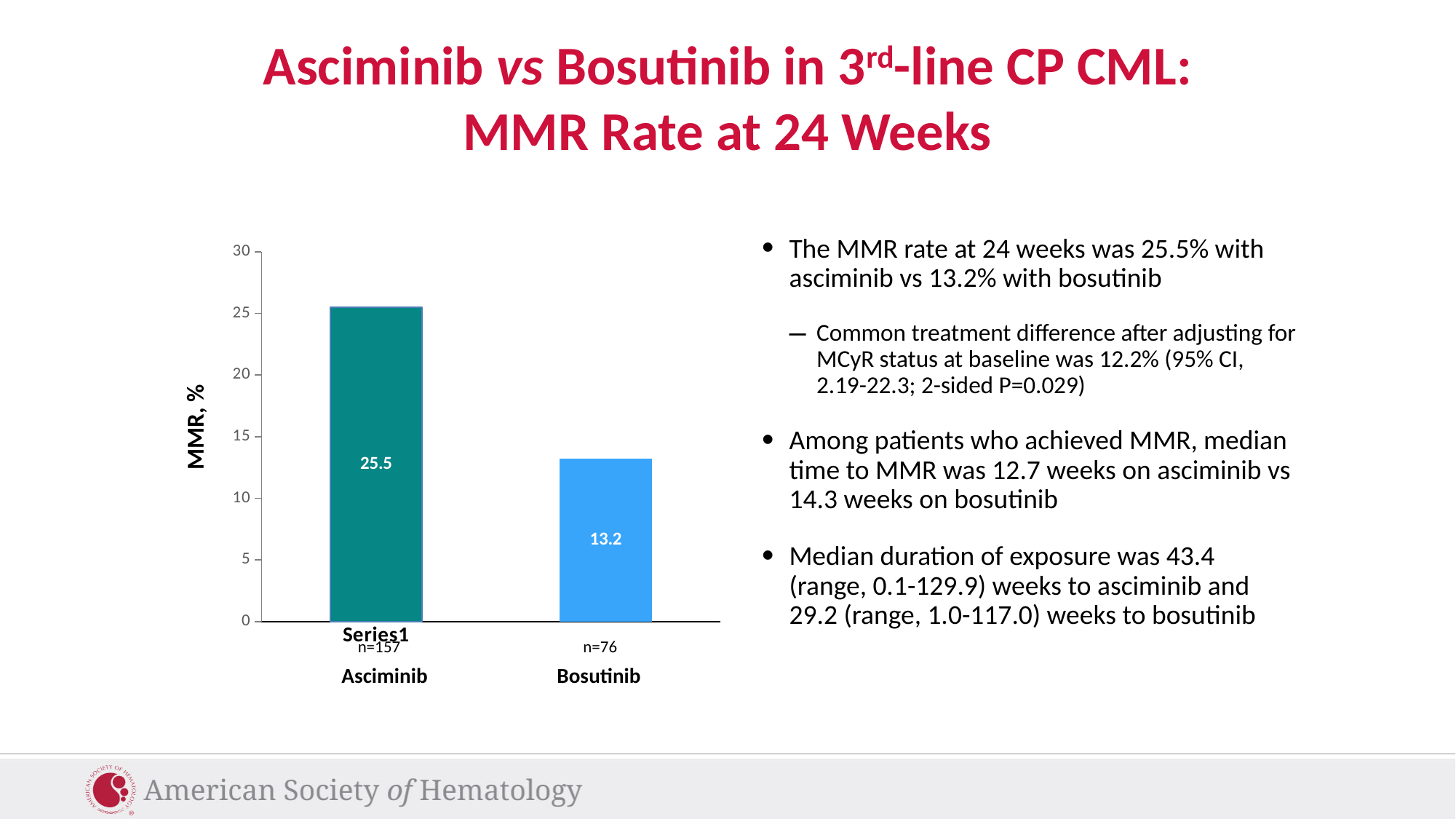
Is the MMR rate for Asciminib greater or less than 25? greater What is the MMR rate shown for Bosutinib in the chart? 13.2 How many bars are plotted in the chart? 2 Is the MMR rate for Bosutinib greater or less than 15? less What is the maximum value shown on the y axis of the chart? 30 What kind of chart is shown on the slide? Bar chart What is the difference between the MMR rates for Asciminib and Bosutinib in the chart? 12.3 What is the label of the y axis in the chart? MMR, % Which treatment has the higher MMR rate in the chart? Asciminib What is the MMR rate shown for Asciminib in the chart? 25.5 What is the number of patients (n) shown under the Asciminib bar? n=157 Which treatment has the lower MMR rate in the chart? Bosutinib